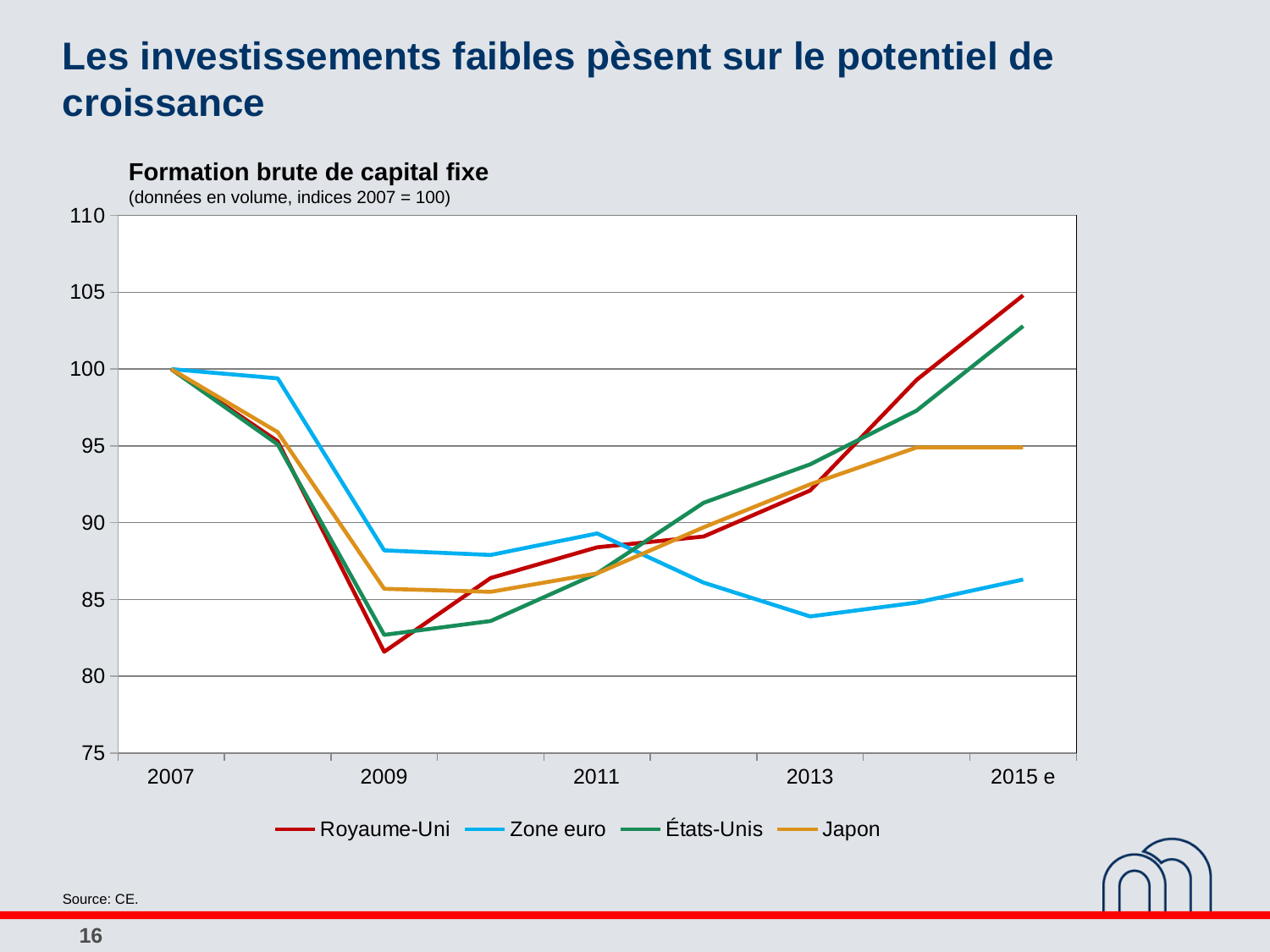
Which series has the highest value in 2015 e? Royaume-Uni Is the value for Zone euro in 2009 greater or less than 85? greater Which series has the lowest value in 2015 e? Zone euro What is the title of the chart? Formation brute de capital fixe Does the Zone euro series rise or fall between 2011 and 2013? fall How many series does the legend list? 4 Is the value for États-Unis in 2009 greater or less than 85? less In 2015 e, which is larger: the value for Japon or the value for Zone euro? Japon Is the value for Royaume-Uni in 2015 e greater or less than 100? greater What kind of chart is shown on the slide? line chart What is the value of the Royaume-Uni series in 2007? 100